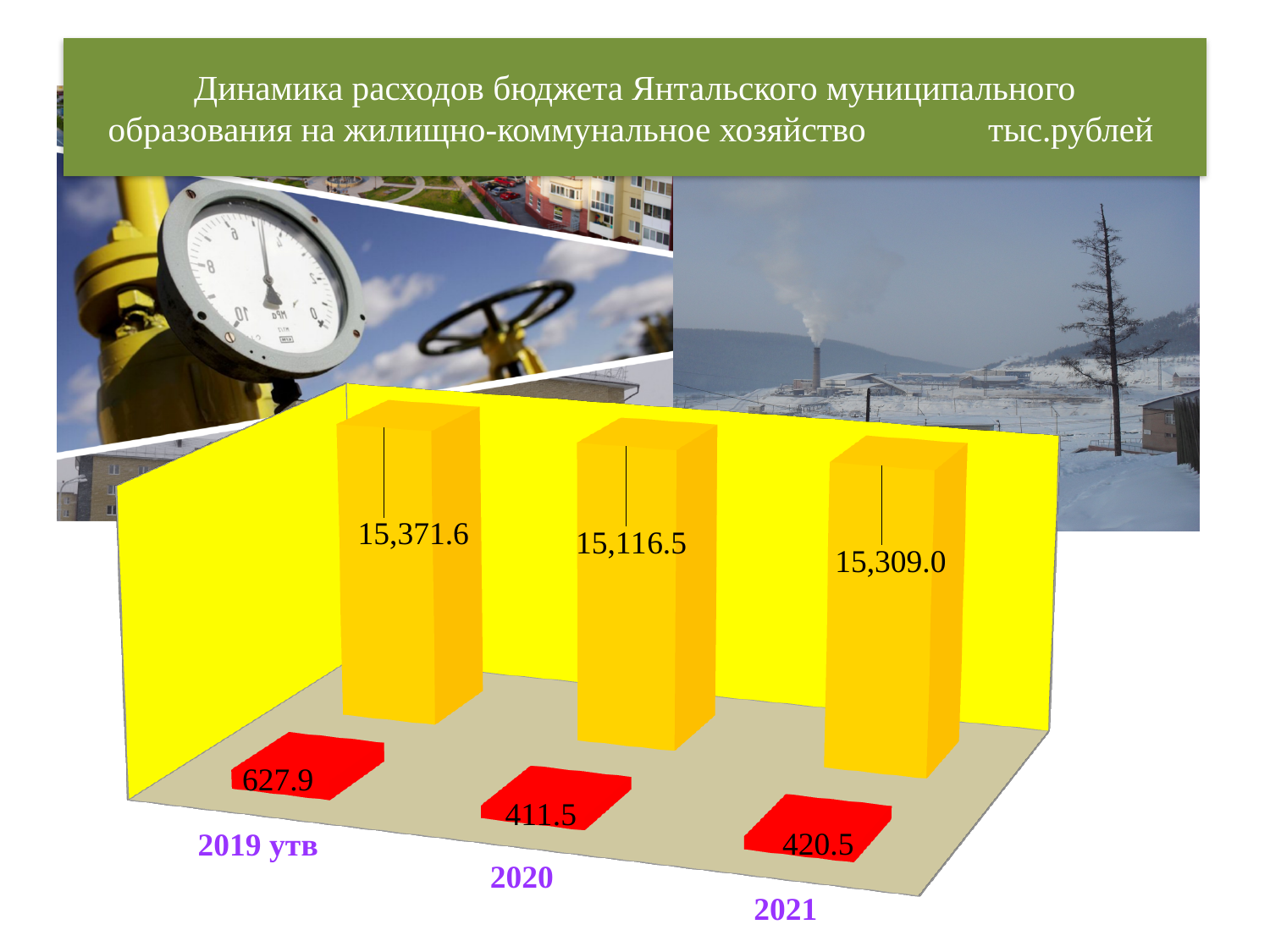
What kind of chart is shown on the slide? bar chart What is the difference between the yellow bar values for 2019 утв and 2020? 255.1 Which year has the lowest value for the red bars? 2020 What is the value of the yellow bar for 2021? 15,309.0 What is the value of the red bar for 2019 утв? 627.9 What is the value of the yellow bar for 2019 утв? 15,371.6 How many years are shown on the x axis of the chart? 3 Which year has the highest value for the yellow bars? 2019 утв What is the value of the red bar for 2021? 420.5 Is the red bar value for 2021 larger or smaller than the red bar value for 2019 утв? smaller What is the value of the yellow bar for 2020? 15,116.5 What is the value of the red bar for 2020? 411.5